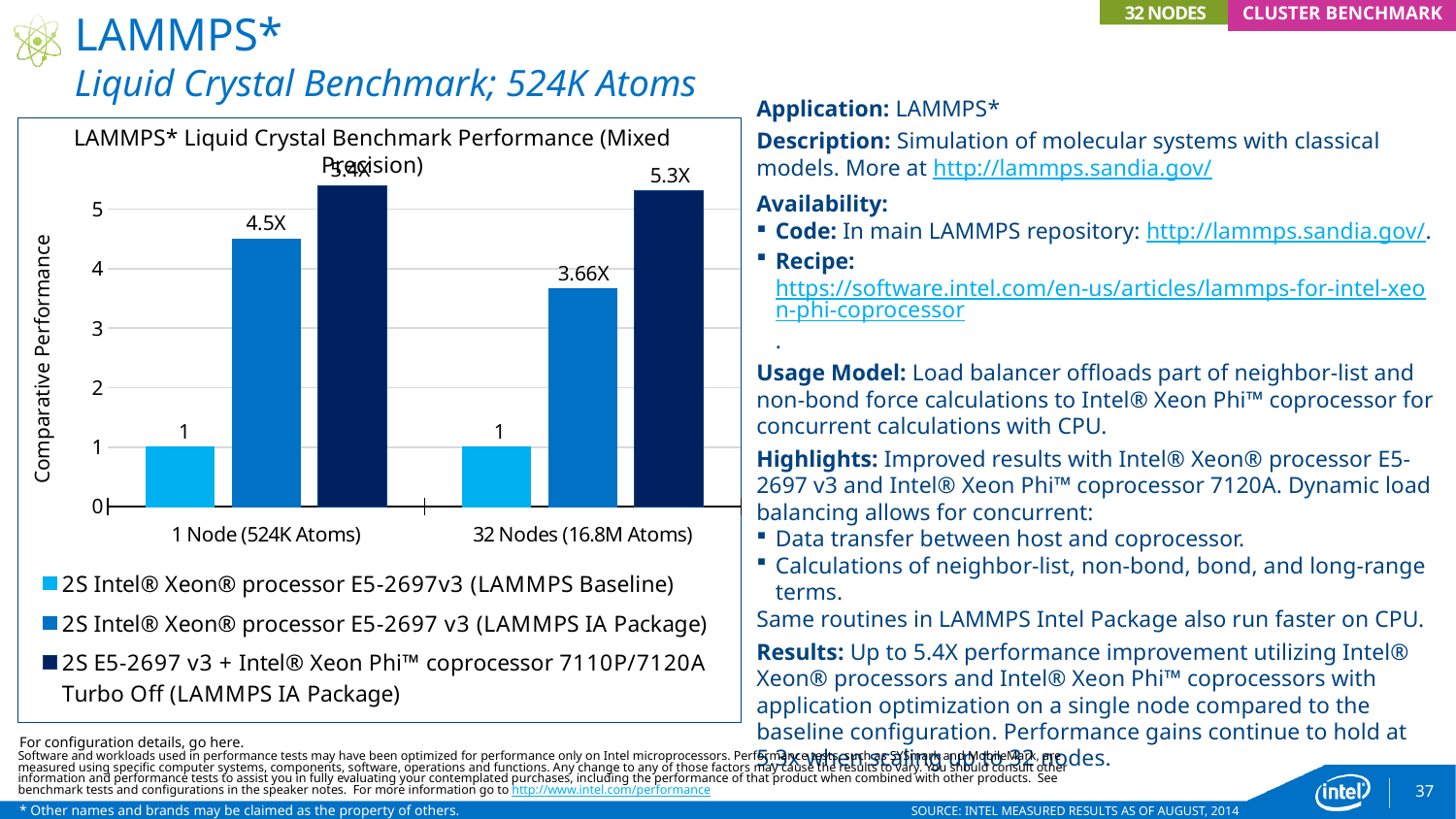
How many categories are shown on the x axis of the chart? 2 What is the title of the chart? LAMMPS* Liquid Crystal Benchmark Performance (Mixed Precision) Which series has the highest value at 32 Nodes (16.8M Atoms)? 2S E5-2697 v3 + Intel® Xeon Phi™ coprocessor 7110P/7120A Turbo Off (LAMMPS IA Package) Which is larger: the LAMMPS IA Package value at 1 Node (524K Atoms) or at 32 Nodes (16.8M Atoms)? 1 Node (524K Atoms) Is the value for the 2S E5-2697 v3 + Intel® Xeon Phi™ coprocessor series at 1 Node (524K Atoms) greater or less than 5? greater Which series has the lowest value at 1 Node (524K Atoms)? 2S Intel® Xeon® processor E5-2697v3 (LAMMPS Baseline) What is the value for the 2S Intel® Xeon® processor E5-2697 v3 (LAMMPS IA Package) series at 1 Node (524K Atoms)? 4.5X What is the value for the 2S Intel® Xeon® processor E5-2697 v3 (LAMMPS IA Package) series at 32 Nodes (16.8M Atoms)? 3.66X How many series does the chart legend list? 3 What is the value for the 2S E5-2697 v3 + Intel® Xeon Phi™ coprocessor 7110P/7120A Turbo Off (LAMMPS IA Package) series at 32 Nodes (16.8M Atoms)? 5.3X What is the value for the 2S Intel® Xeon® processor E5-2697v3 (LAMMPS Baseline) series at 32 Nodes (16.8M Atoms)? 1 What type of chart is shown on the slide? bar chart